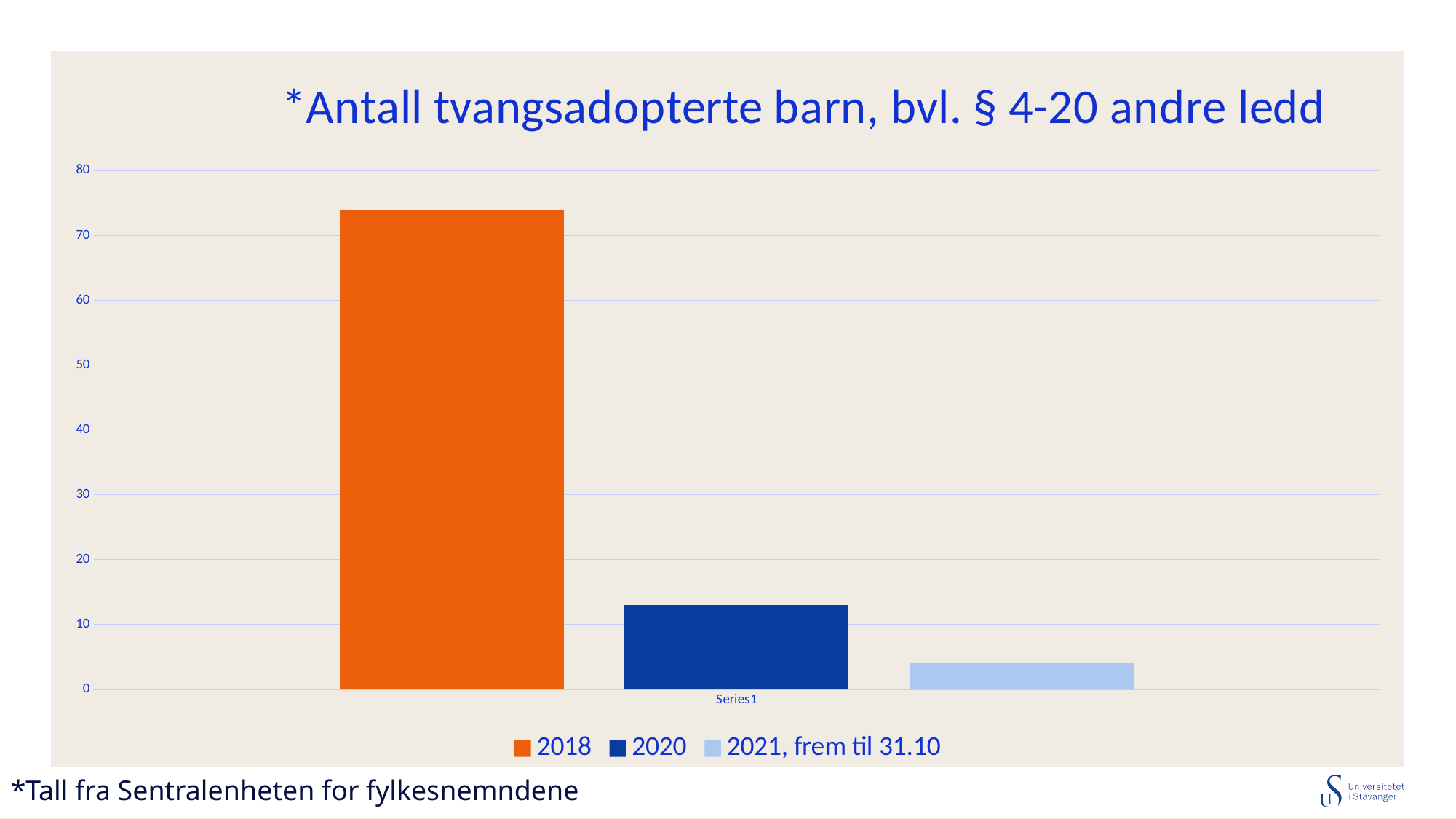
Is the value for 2020 greater or less than 10? greater Which series has the lowest value? 2021, frem til 31.10 Is the value for 2020 greater or less than 20? less Is the value for 2018 greater or less than 70? greater Which is larger, the value for 2018 or the value for 2020? 2018 Which series has the highest value? 2018 Do the values rise or fall from the 2018 bar to the 2021 bar? fall Which is larger, the value for 2020 or the value for 2021, frem til 31.10? 2020 What kind of chart is shown on the slide? bar chart How many series does the legend list? 3 What is the title of the chart? *Antall tvangsadopterte barn, bvl. § 4-20 andre ledd